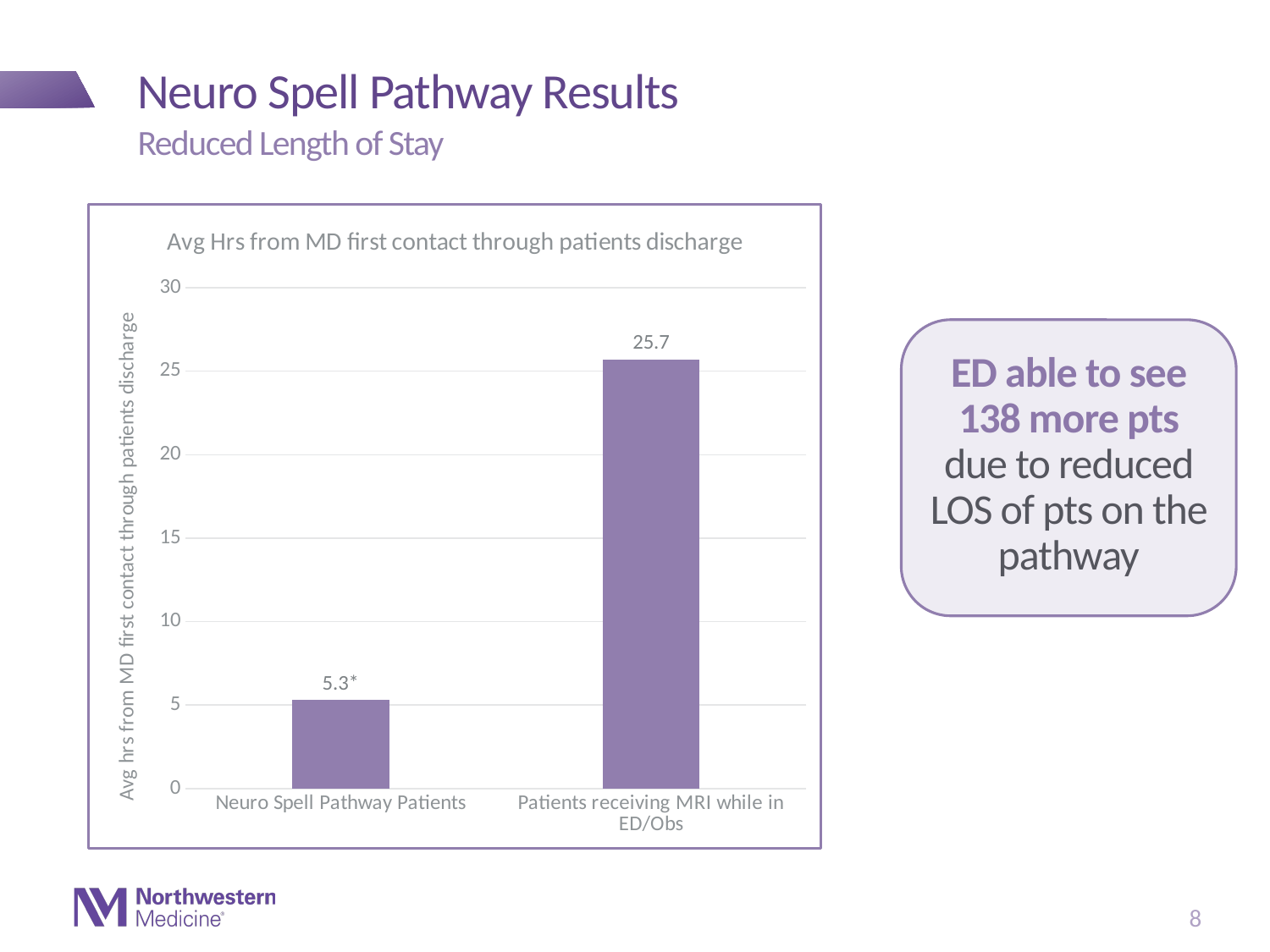
Which category has the highest value? Patients receiving MRI while in ED/Obs How many categories are shown in the chart? 2 What is the difference between the values for Patients receiving MRI while in ED/Obs and Neuro Spell Pathway Patients? 20.4 What kind of chart is shown on the slide? bar chart What is the value for Neuro Spell Pathway Patients? 5.3* What is the title of the chart? Avg Hrs from MD first contact through patients discharge Is the value for Neuro Spell Pathway Patients greater or less than 10? less Is the value for Patients receiving MRI while in ED/Obs greater or less than 20? greater Which category has the lowest value? Neuro Spell Pathway Patients Which is larger, the value for Neuro Spell Pathway Patients or the value for Patients receiving MRI while in ED/Obs? Patients receiving MRI while in ED/Obs What is the value for Patients receiving MRI while in ED/Obs? 25.7 What is the highest value shown on the y axis? 30